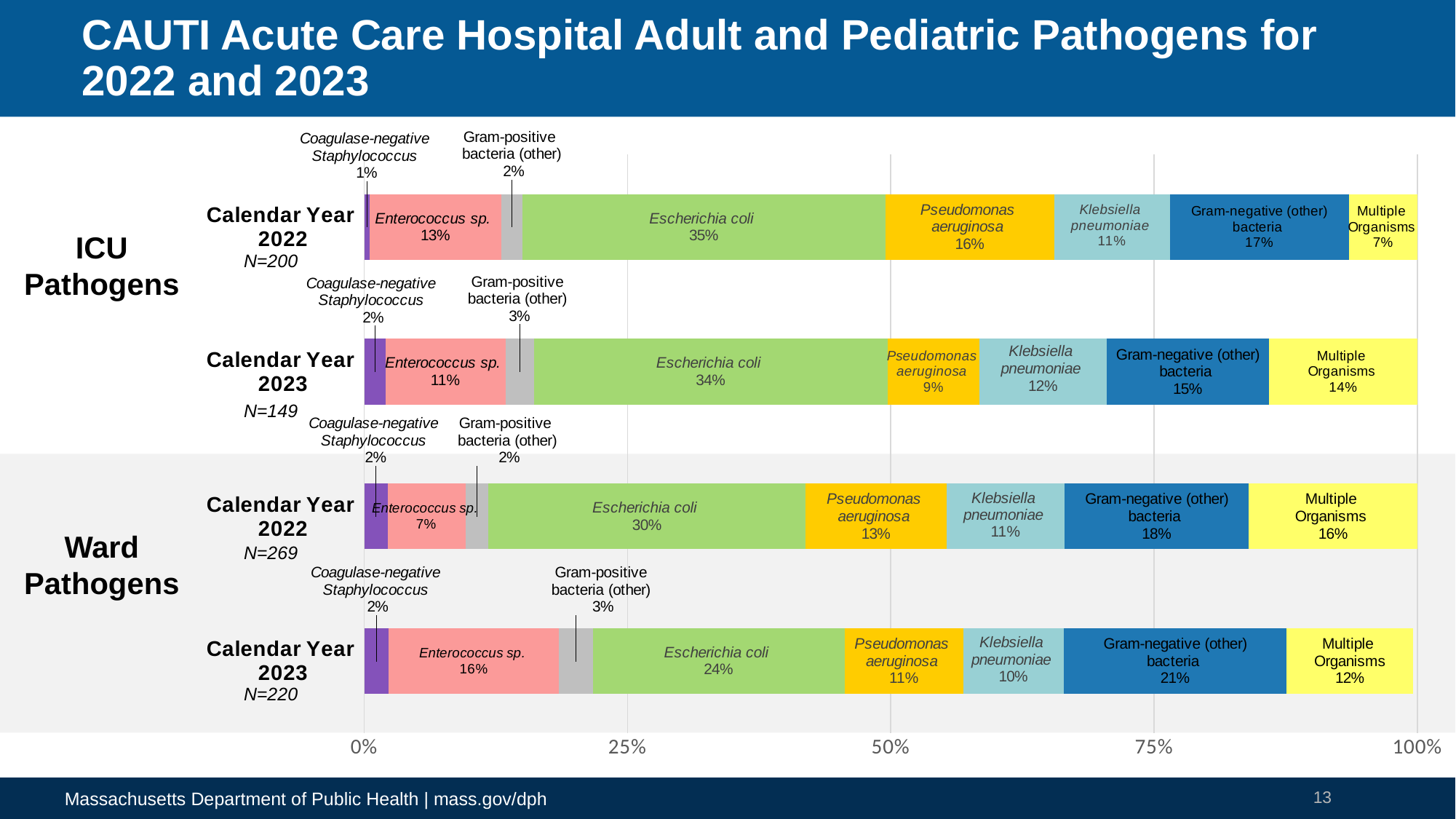
What percentage of Ward pathogens in Calendar Year 2023 was Gram-negative (other) bacteria? 21% Which pathogen category had the smallest share of ICU pathogens in Calendar Year 2022? Coagulase-negative Staphylococcus What percentage of ICU pathogens in Calendar Year 2022 was Escherichia coli? 35% What was the N for ICU Pathogens in Calendar Year 2023? N=149 How many bars (calendar year groups) are shown in the chart? 4 Which was larger for ICU pathogens in Calendar Year 2023: Pseudomonas aeruginosa or Multiple Organisms? Multiple Organisms What is the difference between the Gram-negative (other) bacteria share of ICU pathogens in Calendar Year 2022 and Calendar Year 2023? 2 percentage points What is the difference between the Escherichia coli share of Ward pathogens in Calendar Year 2022 and Calendar Year 2023? 6 percentage points What colour is used for the Escherichia coli segments in the chart? Green What type of chart is shown on the slide? Stacked bar chart Did the Enterococcus sp. share of Ward pathogens rise or fall from Calendar Year 2022 to Calendar Year 2023? Rise Which pathogen category had the largest share of ICU pathogens in Calendar Year 2022? Escherichia coli